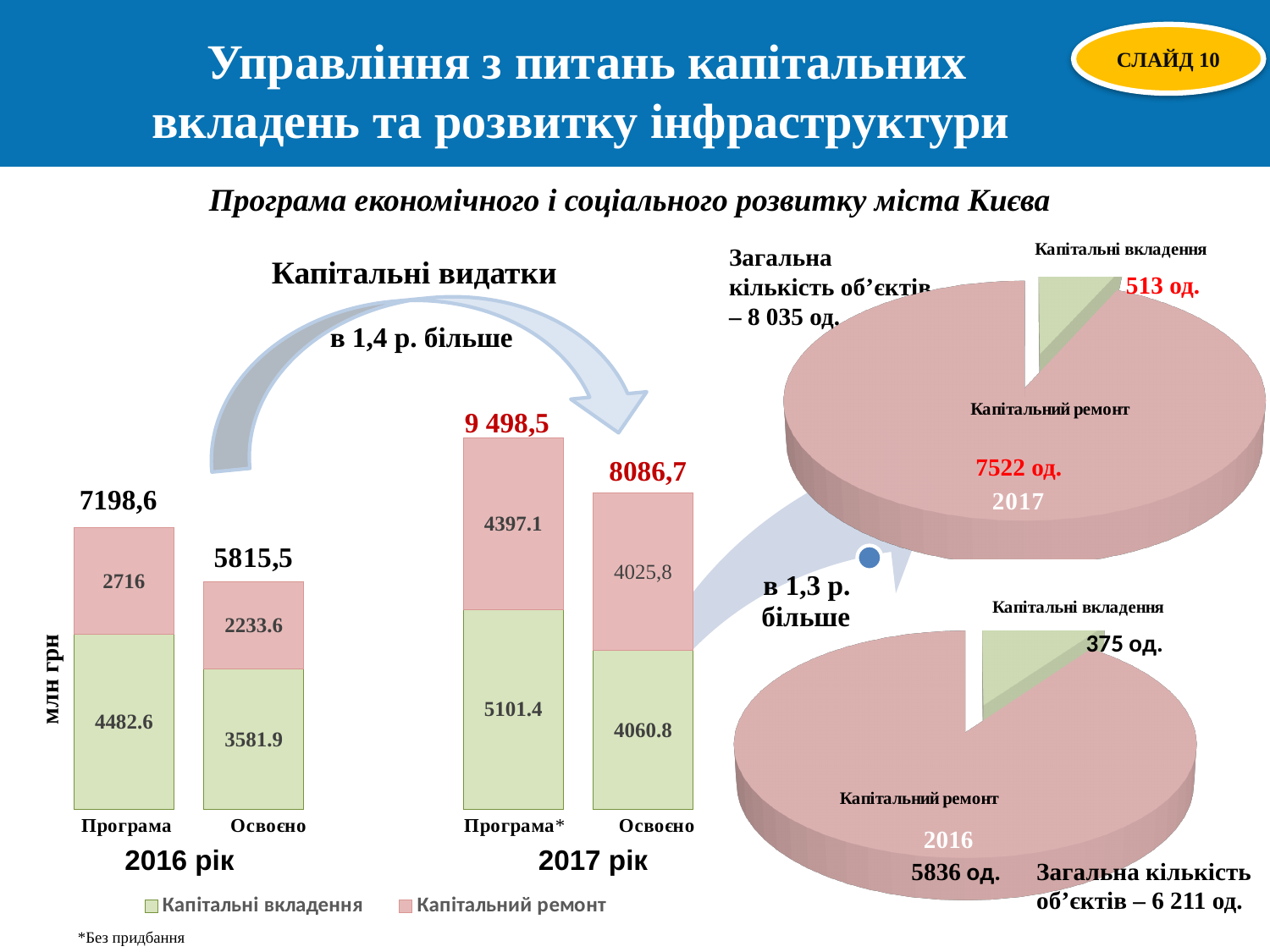
In the bar chart 'Капітальні видатки', what is the total of the 'Програма*' bar for 2017? 9 498,5 In the bar chart 'Капітальні видатки', which bar has the lowest total? Освоєно (2016 рік) What kind of chart is 'Капітальні видатки'? Stacked bar chart In the bar chart 'Капітальні видатки', what is the total of the 'Освоєно' bar for 2016? 5815,5 In the pie chart for 2016, which slice is larger: 'Капітальний ремонт' or 'Капітальні вкладення'? Капітальний ремонт In the bar chart 'Капітальні видатки', which bar has the highest total? Програма* (2017 рік) In the bar chart 'Капітальні видатки', what is the difference between 'Капітальні вкладення' for 'Програма*' 2017 and 'Освоєно' 2017? 1040.6 In the bar chart 'Капітальні видатки', what is the value of 'Капітальні вкладення' for 'Програма' in 2016? 4482.6 In the bar chart 'Капітальні видатки', how many series does the legend list? 2 In the pie chart for 2016, how many units are 'Капітальний ремонт'? 5836 од. In the pie chart for 2017, how many units are 'Капітальні вкладення'? 513 од. In the bar chart 'Капітальні видатки', what is the value of 'Капітальний ремонт' for 'Освоєно' in 2017? 4025,8